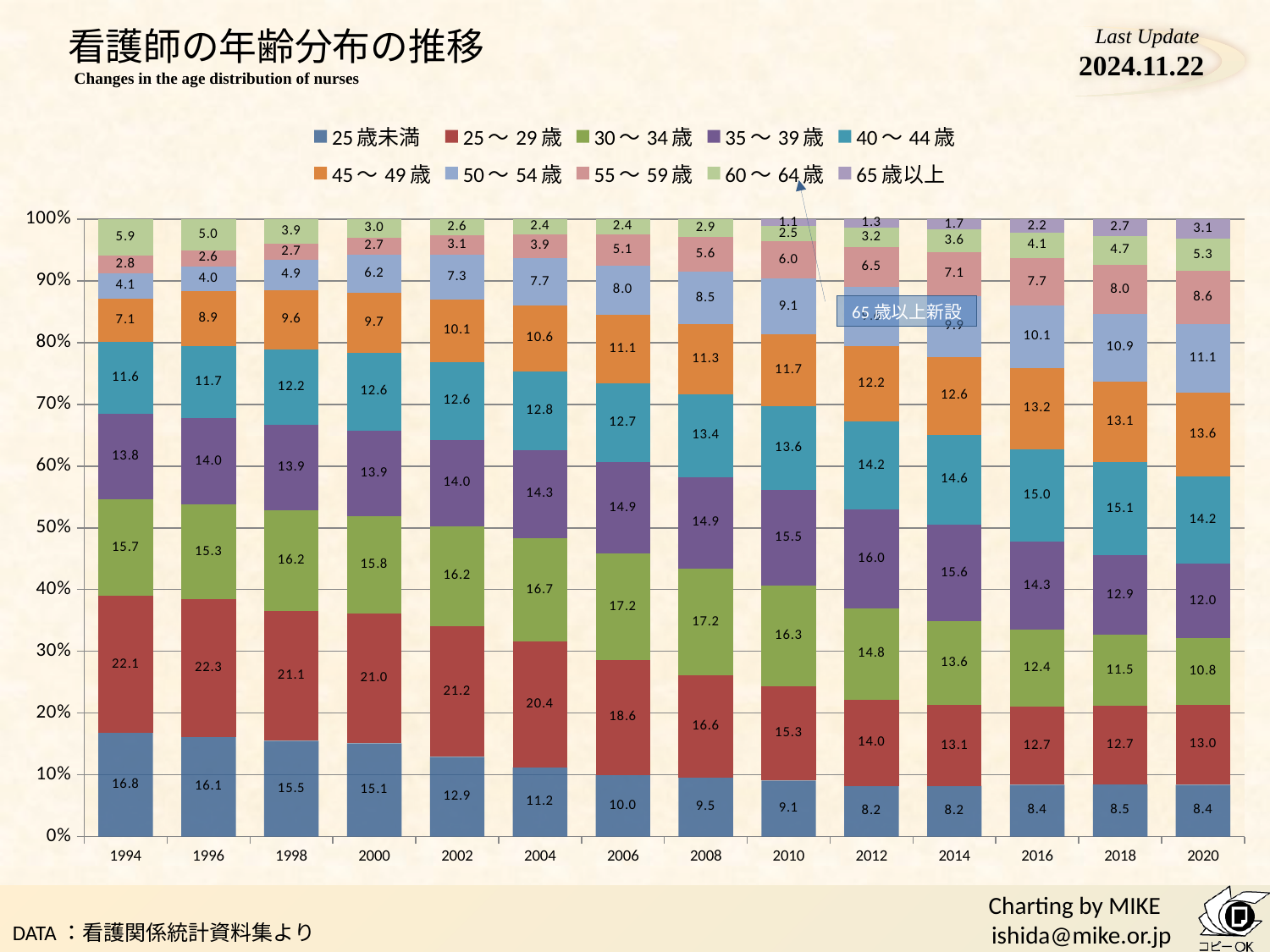
Does the 45～49歳 share generally rise or fall from 1994 to 2020? Rise What is the value for 25～29歳 in 2004? 20.4 What is the value for 25歳未満 in 1994? 16.8 In which year is the 25歳未満 share highest? 1994 Which is larger in 2010: the value for 35～39歳 or the value for 30～34歳? 30～34歳 How many series does the legend list? 10 What is the value for 45～49歳 in 2016? 13.2 How many years are shown along the x axis? 14 What is the difference between the 25～29歳 values in 1994 and 2020? 9.1 In which year is the 55～59歳 share lowest? 1996 What is the value for 65歳以上 in 2020? 3.1 What kind of chart is shown on the slide? Stacked bar chart